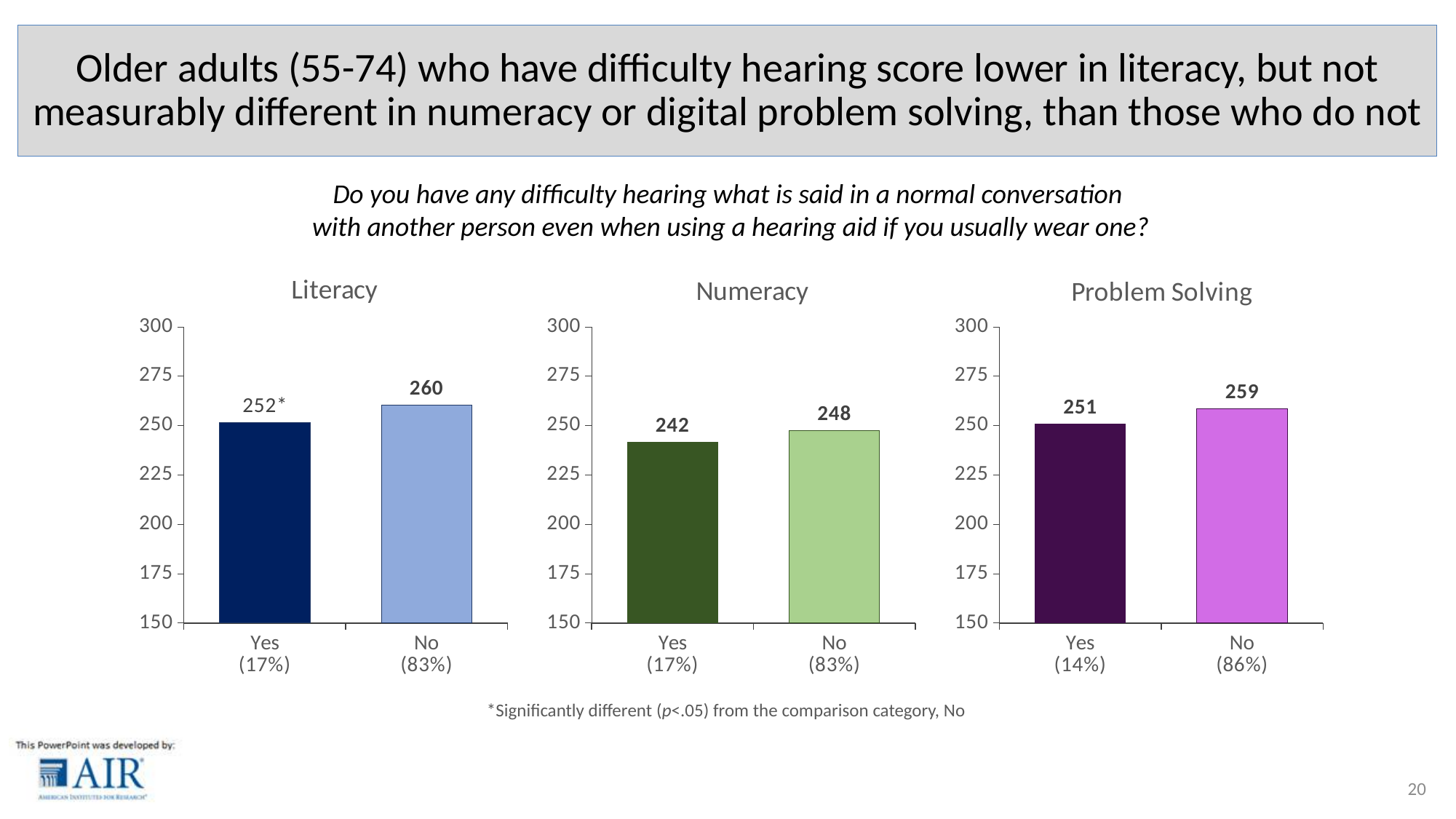
In the Numeracy chart, what is the difference between the No and Yes values? 6 In the Numeracy chart, what is the value for Yes (17%)? 242 In the Problem Solving chart, what is the value for No (86%)? 259 What kind of chart is the Numeracy chart? bar chart In the Problem Solving chart, which category has the higher value, Yes or No? No How many bars are shown in the Literacy chart? 2 In the Literacy chart, what is the value for No (83%)? 260 In the Numeracy chart, which category has the lowest value? Yes (17%) In the Problem Solving chart, is the value for Yes (14%) greater or less than 225? greater In the Literacy chart, what is the difference between the No and Yes values? 8 In the Literacy chart, what is the value for Yes (17%)? 252 How many charts are shown on the slide? 3